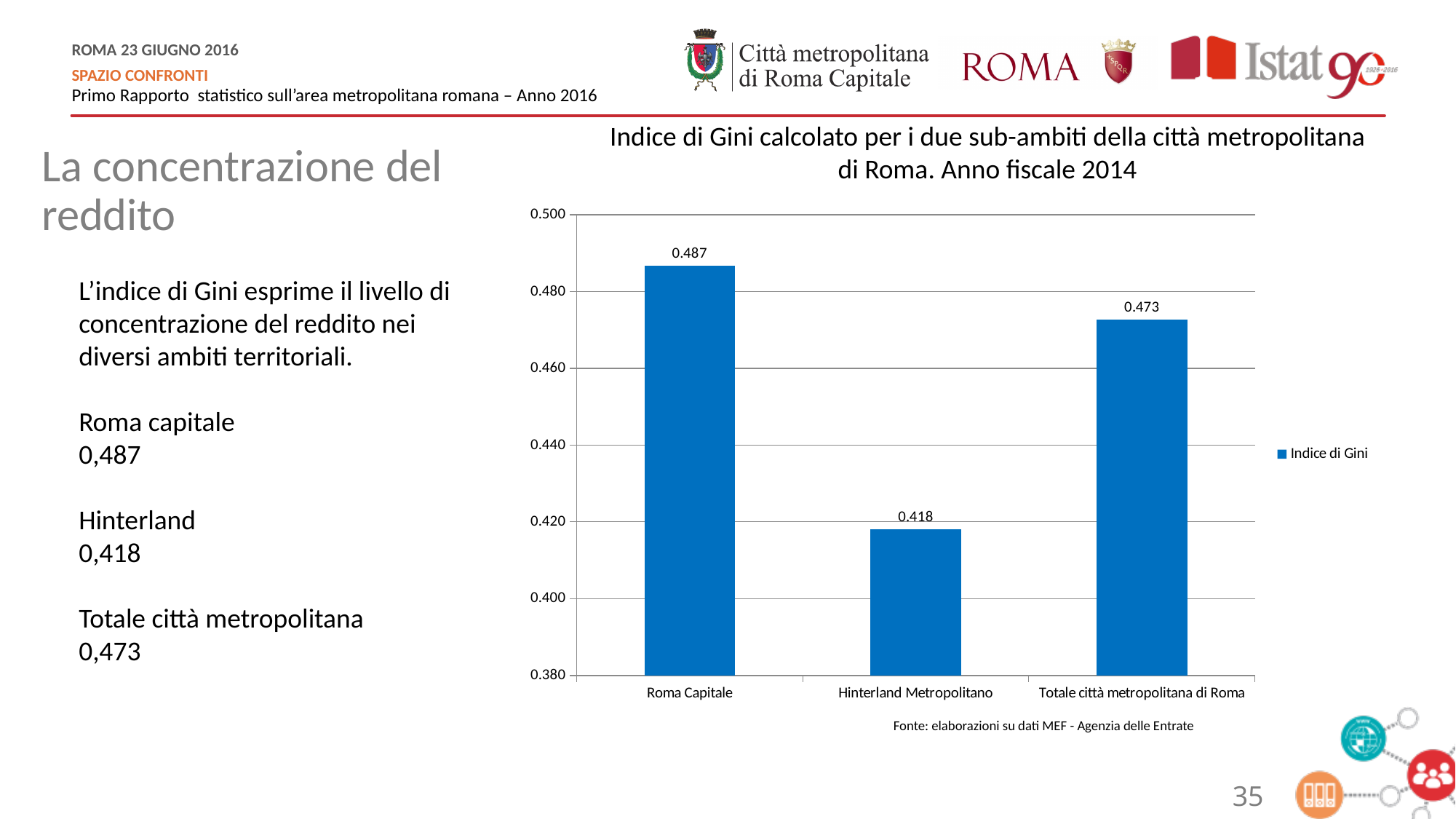
Which category has the highest Gini index? Roma Capitale What is the Gini index value for Hinterland Metropolitano? 0.418 What is the difference between the Gini index for Roma Capitale and for Totale città metropolitana di Roma? 0.014 What series name does the chart legend list? Indice di Gini How many categories are shown on the x axis of the chart? 3 What is the difference between the Gini index for Roma Capitale and for Hinterland Metropolitano? 0.069 Which is larger, the Gini index for Hinterland Metropolitano or for Totale città metropolitana di Roma? Totale città metropolitana di Roma What is the Gini index value for Totale città metropolitana di Roma? 0.473 Is the value for Hinterland Metropolitano greater or less than 0.440? less What kind of chart is shown on the slide? bar chart What is the Gini index value for Roma Capitale? 0.487 Which category has the lowest Gini index? Hinterland Metropolitano